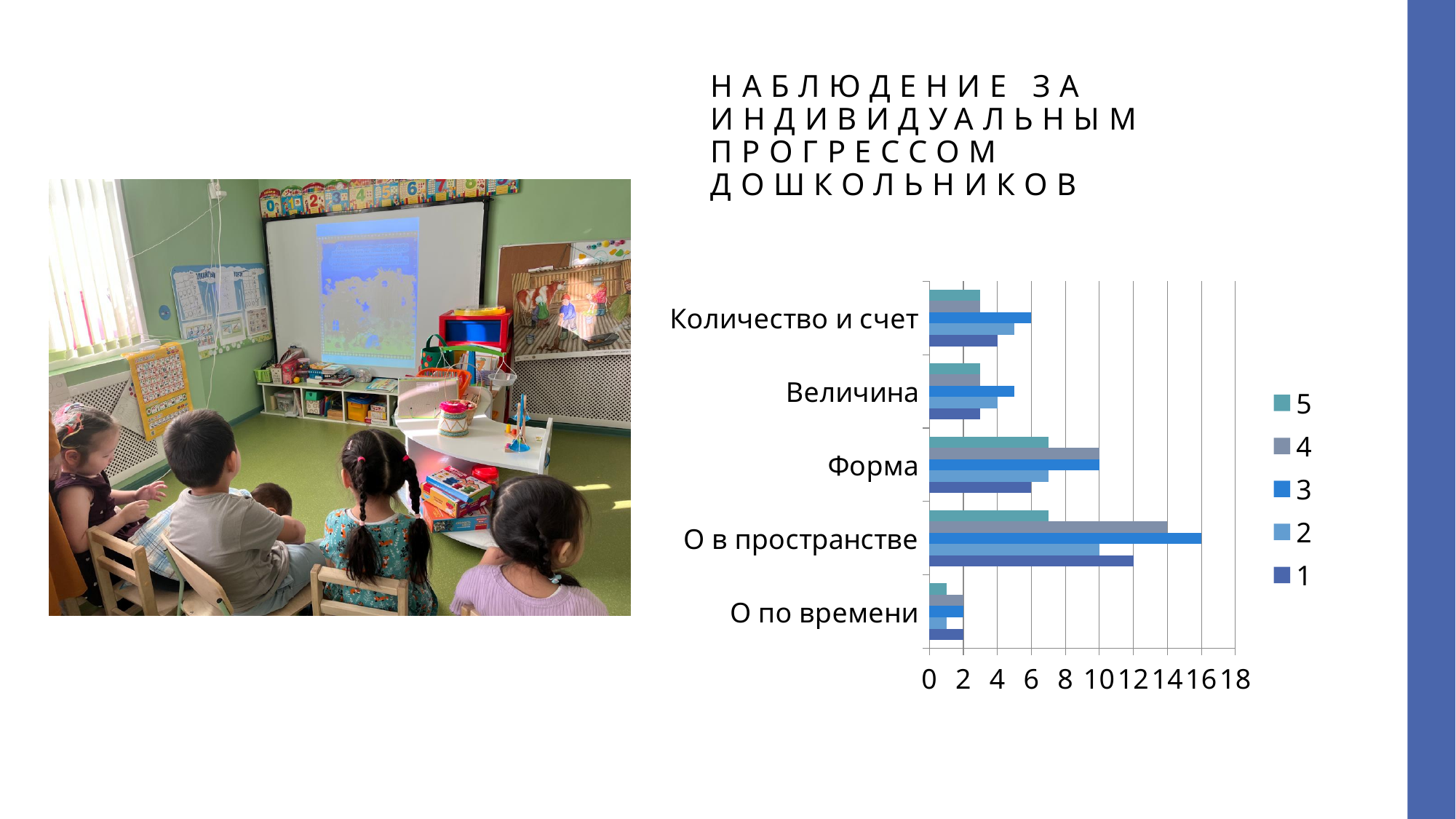
Which is larger: the value of series 3 for Форма or the value of series 3 for Величина? Форма Which category has the shortest bars on the chart? О по времени What kind of chart is shown on the slide? bar chart What is the value of series 3 for О в пространстве? 16 Is the value of series 5 for Величина greater or less than 4? less Is the value of series 1 for О в пространстве greater or less than 10? greater How many series does the chart legend list? 5 Which category has the longest bar on the chart? О в пространстве What is the value of series 3 for Форма? 10 Is the value of series 4 for О в пространстве greater or less than 12? greater How many categories are shown on the chart? 5 What is the highest value shown on the horizontal axis of the chart? 18